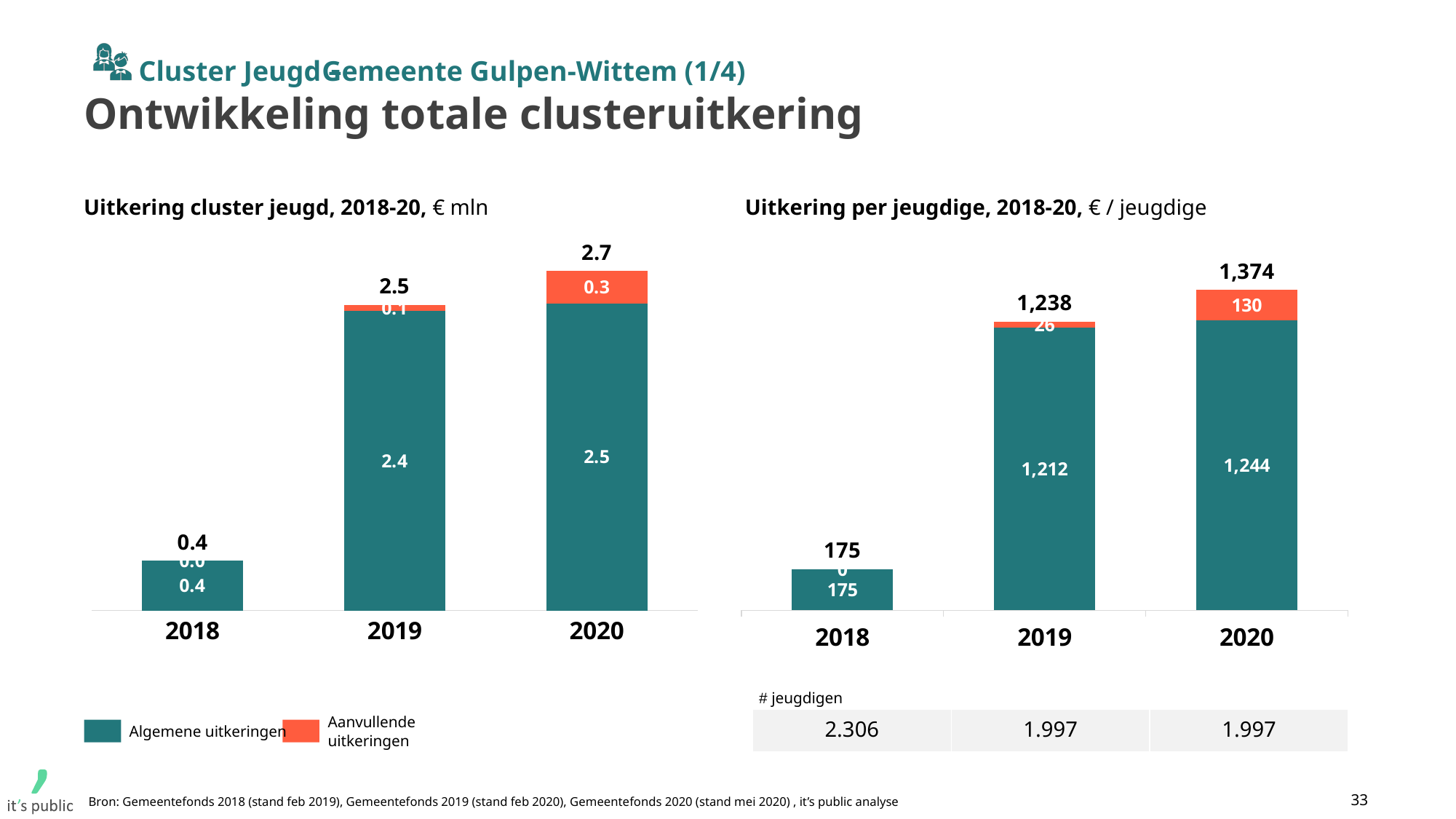
In the chart 'Uitkering per jeugdige, 2018-20', what is the value of Aanvullende uitkeringen for 2020? 130 In the chart 'Uitkering per jeugdige, 2018-20', what is the value of Algemene uitkeringen for 2020? 1,244 In the chart 'Uitkering per jeugdige, 2018-20', is the total for 2019 larger or smaller than the total for 2018? larger In the chart 'Uitkering per jeugdige, 2018-20', what is the total value for 2019? 1,238 In the chart 'Uitkering cluster jeugd, 2018-20', what is the value of Algemene uitkeringen for 2019? 2.4 In the chart 'Uitkering per jeugdige, 2018-20', which year has the highest total? 2020 In the chart 'Uitkering cluster jeugd, 2018-20', what is the value of Aanvullende uitkeringen for 2020? 0.3 How many series does the legend list for the chart 'Uitkering cluster jeugd, 2018-20'? 2 What kind of chart is 'Uitkering cluster jeugd, 2018-20'? stacked bar chart In the chart 'Uitkering cluster jeugd, 2018-20', what is the total value for 2020? 2.7 In the chart 'Uitkering per jeugdige, 2018-20', what is the difference between the totals for 2020 and 2019? 136 In the chart 'Uitkering cluster jeugd, 2018-20', which year has the lowest total? 2018